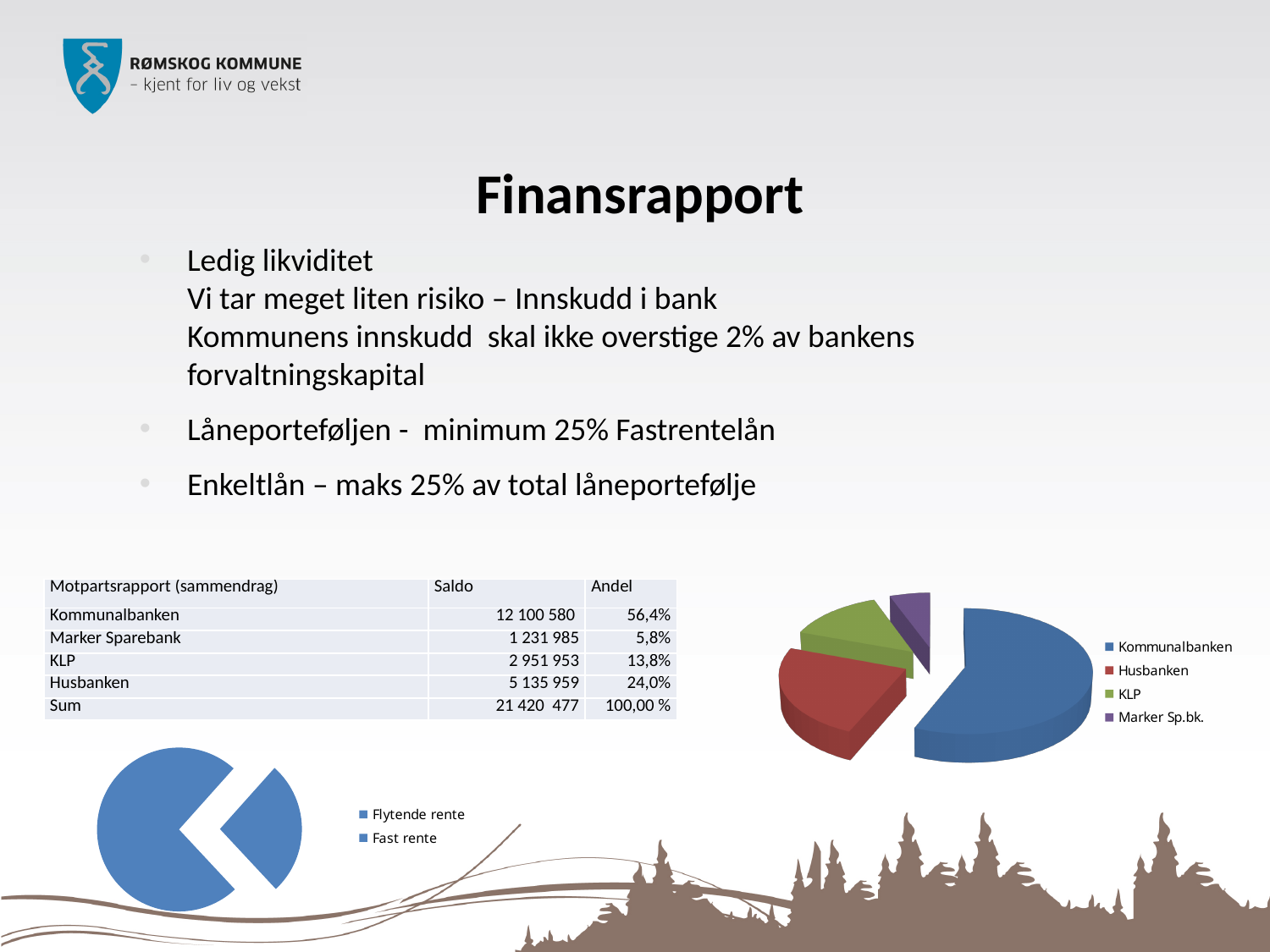
How many slices does the pie chart on the right side of the slide have? 4 What kind of chart is the chart at the bottom left of the slide? pie chart In the pie chart on the right side of the slide, which category has the smallest slice? Marker Sp.bk. In the pie chart on the right side of the slide, which category has the largest slice? Kommunalbanken What kind of chart is the chart on the right side of the slide? pie chart How many entries does the legend of the pie chart on the right side of the slide list? 4 According to the table on the slide, what share of the total does Husbanken have in the pie chart on the right? 24,0% How many entries does the legend of the pie chart at the bottom left of the slide list? 2 In the pie chart on the right side of the slide, what colour is the Kommunalbanken slice? blue In the pie chart on the right side of the slide, which slice is larger, Husbanken or KLP? Husbanken According to the table on the slide, what share of the total does Kommunalbanken have in the pie chart on the right? 56,4% What are the two legend entries of the pie chart at the bottom left of the slide? Flytende rente and Fast rente